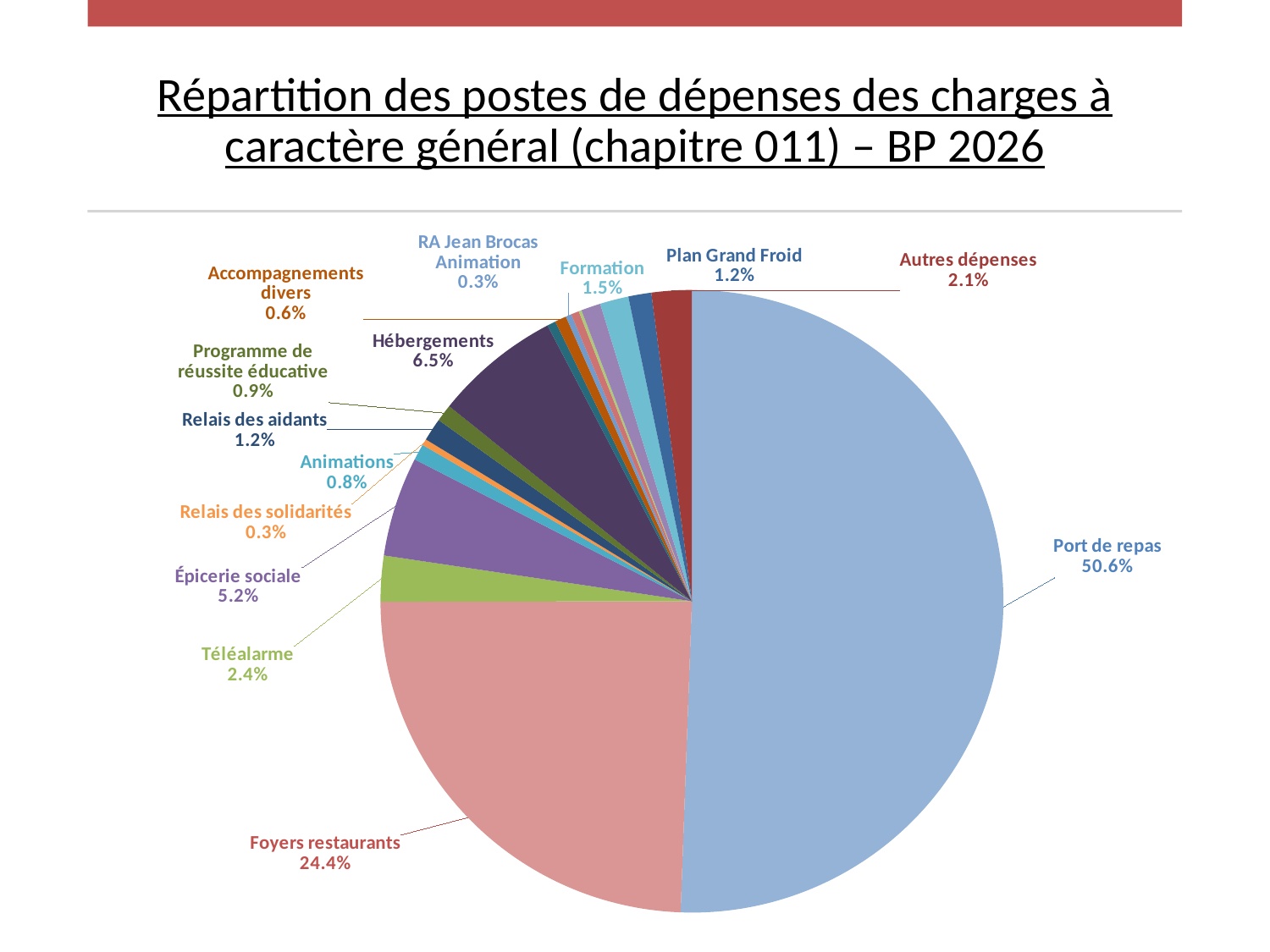
What is the title of the chart on the slide? Répartition des postes de dépenses des charges à caractère général (chapitre 011) – BP 2026 Which category has the largest slice of the pie? Port de repas What share of the pie does Port de repas represent? 50.6% What is the value shown for Hébergements? 6.5% Which is larger, Hébergements or Épicerie sociale? Hébergements What is the difference in percentage points between Port de repas and Foyers restaurants? 26.2 Which is larger, Épicerie sociale or Téléalarme? Épicerie sociale What is the value shown for Formation? 1.5% What is the value shown for Foyers restaurants? 24.4% What is the value shown for Autres dépenses? 2.1% What kind of chart is shown on the slide? pie chart